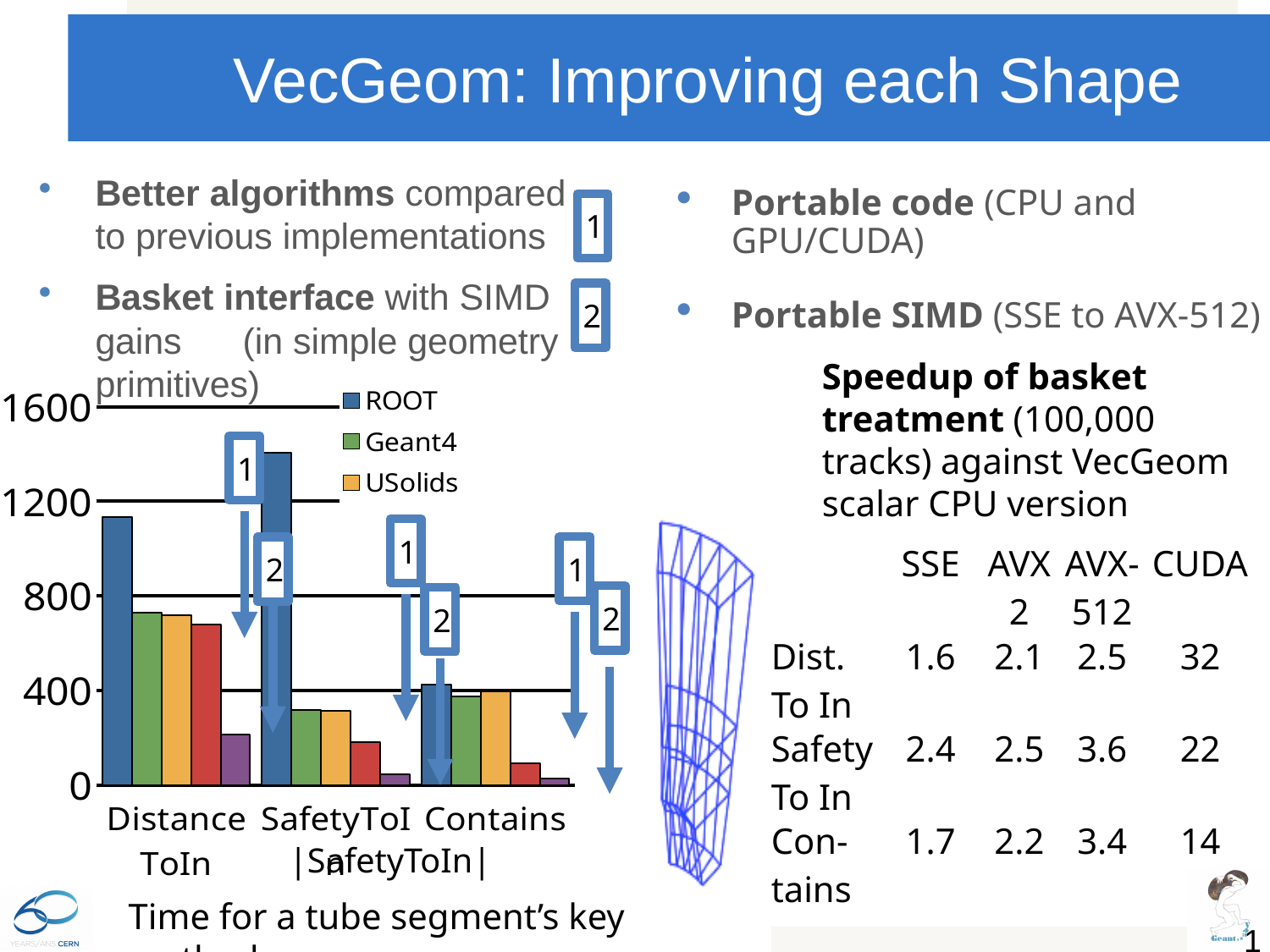
In the bar chart, which category has the tallest ROOT bar? SafetyToIn How many categories are shown on the x axis of the bar chart? 3 Is the ROOT value for DistanceToIn greater or less than 800? greater What kind of chart is shown on the left of the slide? bar chart Is the ROOT value for Contains greater or less than 800? less How many series does the legend of the bar chart list? 3 Is the Geant4 value for DistanceToIn greater or less than 400? greater In the bar chart, which category has the shortest ROOT bar? Contains What is the highest tick value shown on the y axis of the bar chart? 1600 For DistanceToIn, which is larger: the ROOT value or the Geant4 value? ROOT